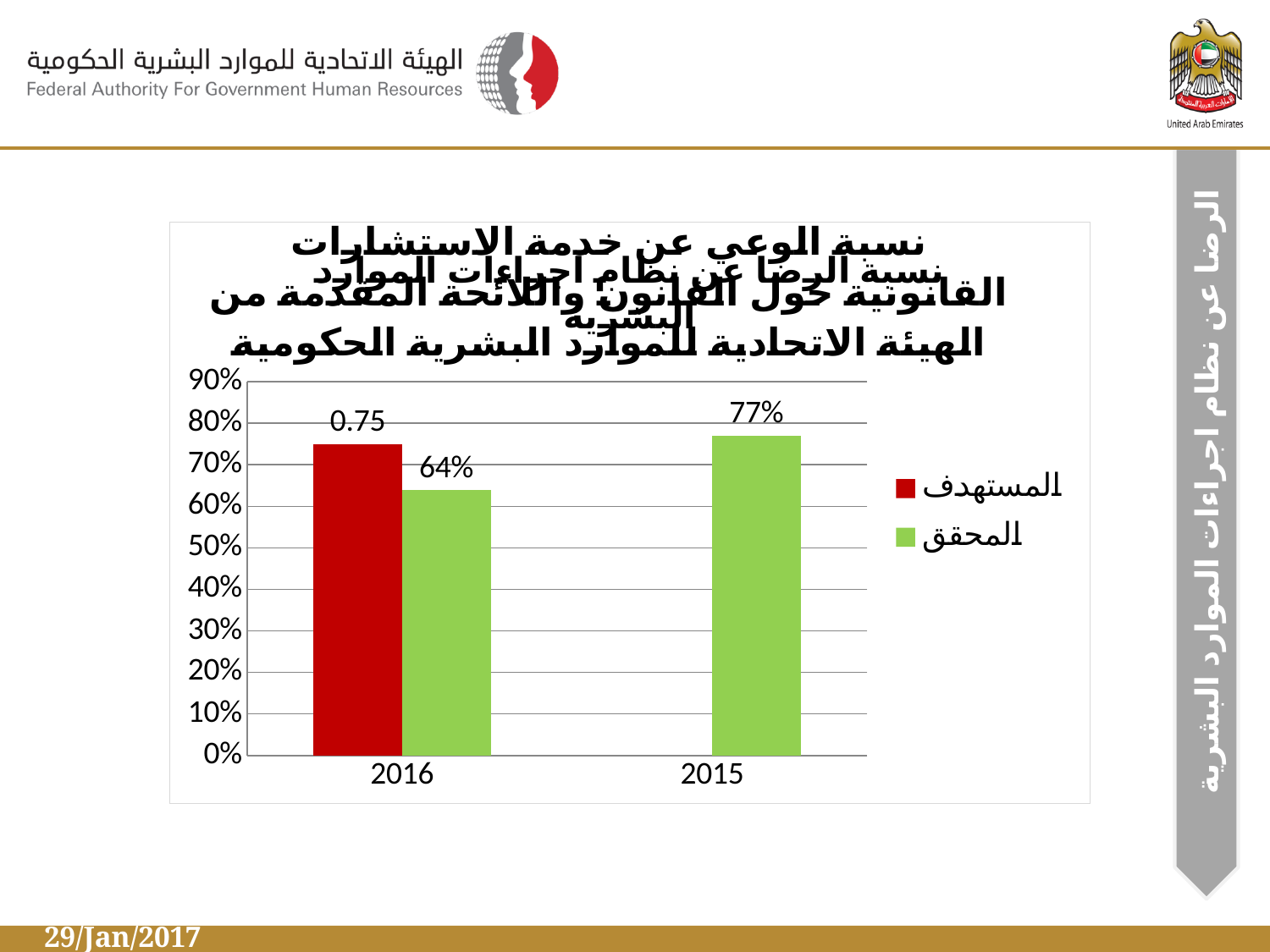
Which colour represents the المستهدف (target) series in the legend? red Is the المحقق (achieved) value for 2015 greater or less than 70%? greater Which year has the higher المحقق (achieved) value, 2016 or 2015? 2015 How many series does the legend list? 2 What kind of chart is shown on the slide? bar chart What is the value of the المستهدف (target) bar for 2016? 0.75 What is the value of the المحقق (achieved) bar for 2015? 77% Which year has no المستهدف (target) bar plotted? 2015 What is the value of the المحقق (achieved) bar for 2016? 64% How many categories are shown on the x axis? 2 What is the difference between the المحقق (achieved) values for 2015 and 2016? 13% Is the المحقق (achieved) value for 2016 greater or less than 70%? less